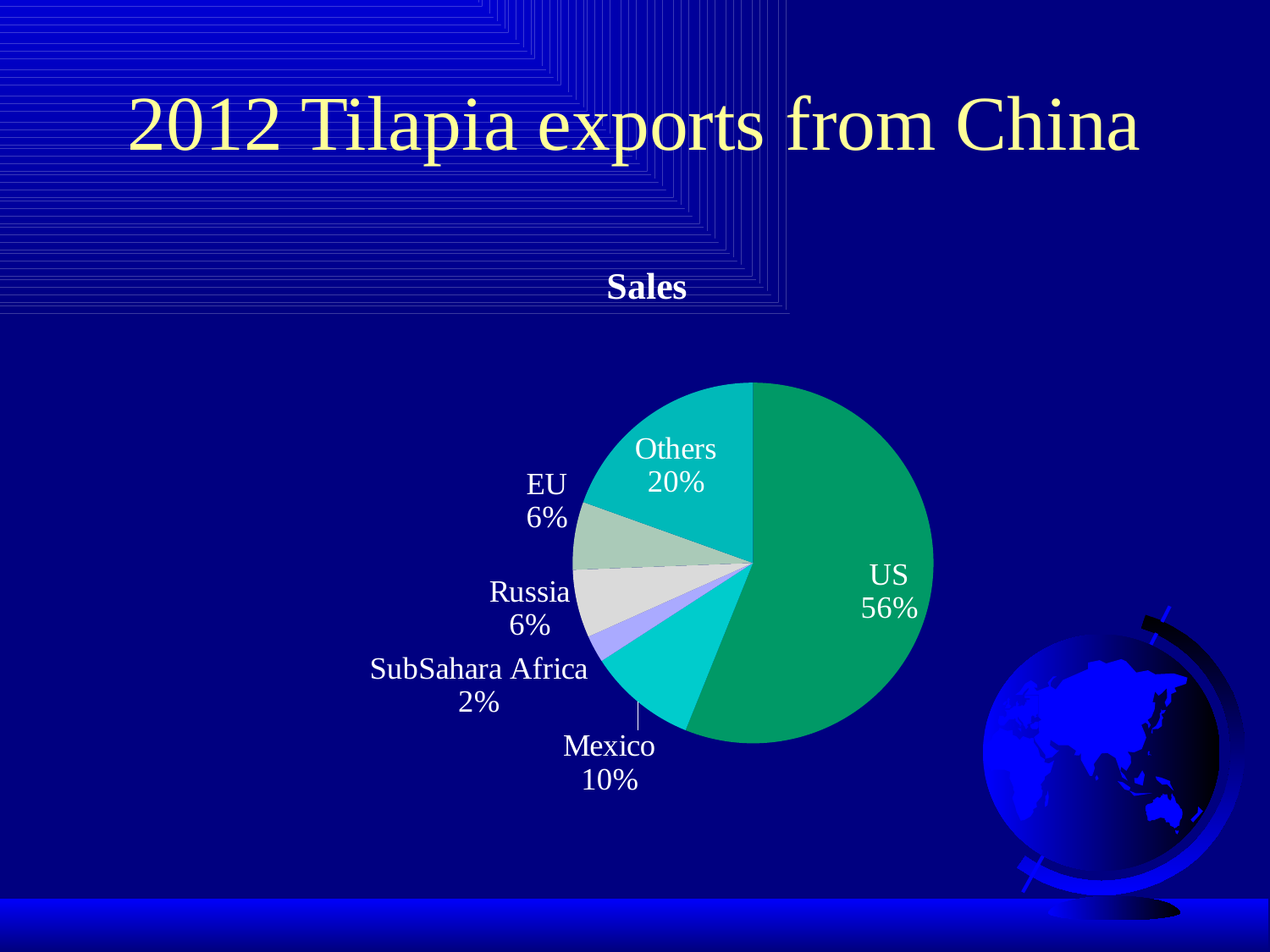
Which category has the largest slice? US Which category has the smallest slice? SubSahara Africa What is the value for Mexico? 10% What is the chart's title? Sales What is the value for Russia? 6% What is the difference between the US share and the Others share? 36% What kind of chart is shown on the slide? pie chart What share of the pie does the Others slice have? 20% What share of the pie does the US slice have? 56% How many slices does the pie chart have? 6 What is the value for SubSahara Africa? 2% Which is larger, the Mexico slice or the EU slice? Mexico